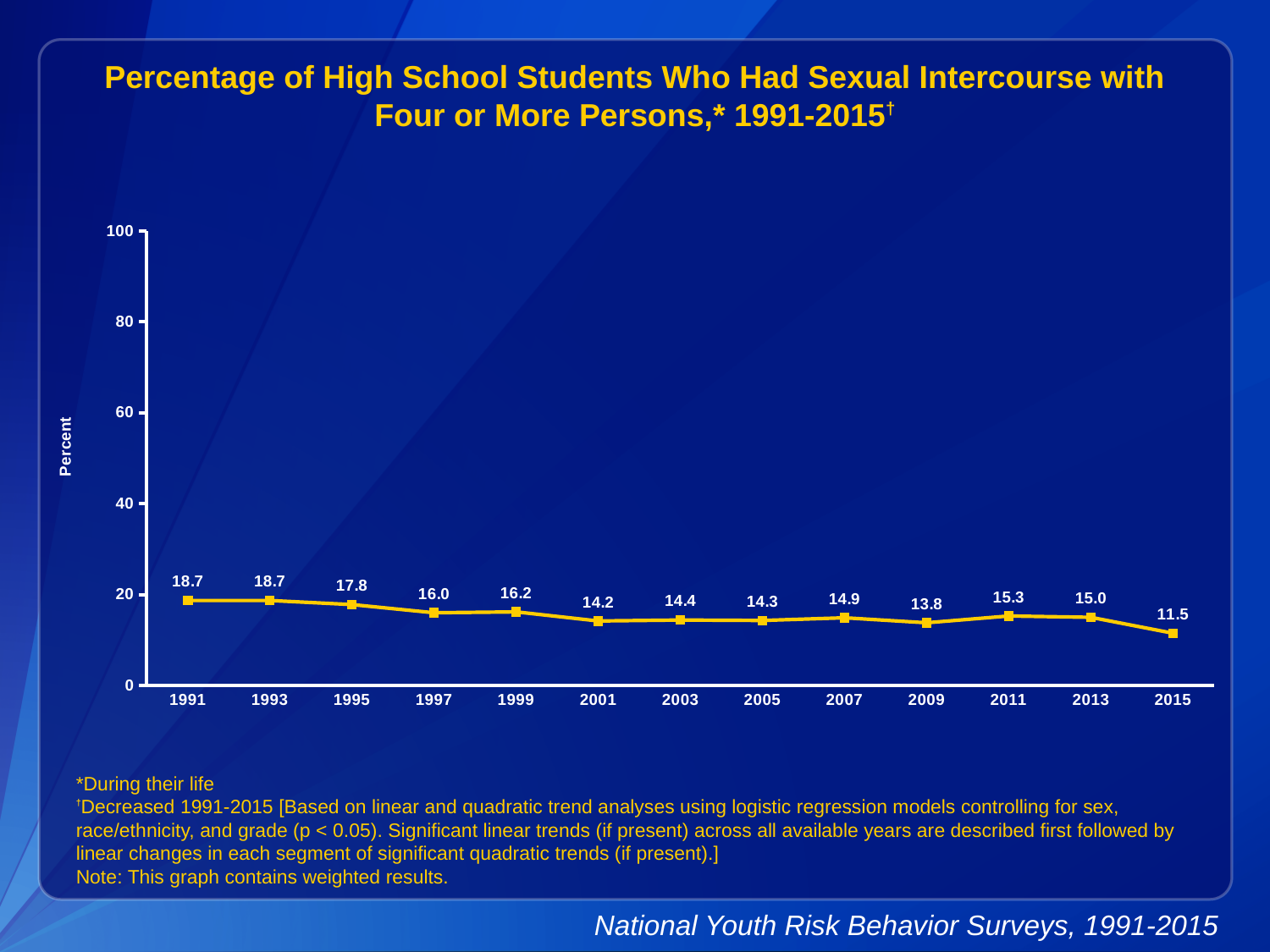
What is the difference between the values for 2011 and 2013? 0.3 What is the value for 1991? 18.7 What is the value for 2015? 11.5 Which is larger, the value for 2011 or the value for 2001? 2011 Do the values generally rise or fall from 1991 to 2015? fall What is the label on the y axis? Percent Which year has the lowest value? 2015 What kind of chart is shown? line chart What is the value for 2009? 13.8 How many years are plotted on the chart? 13 What is the difference between the values for 1991 and 2015? 7.2 Is the value for 1995 greater or less than 20? less